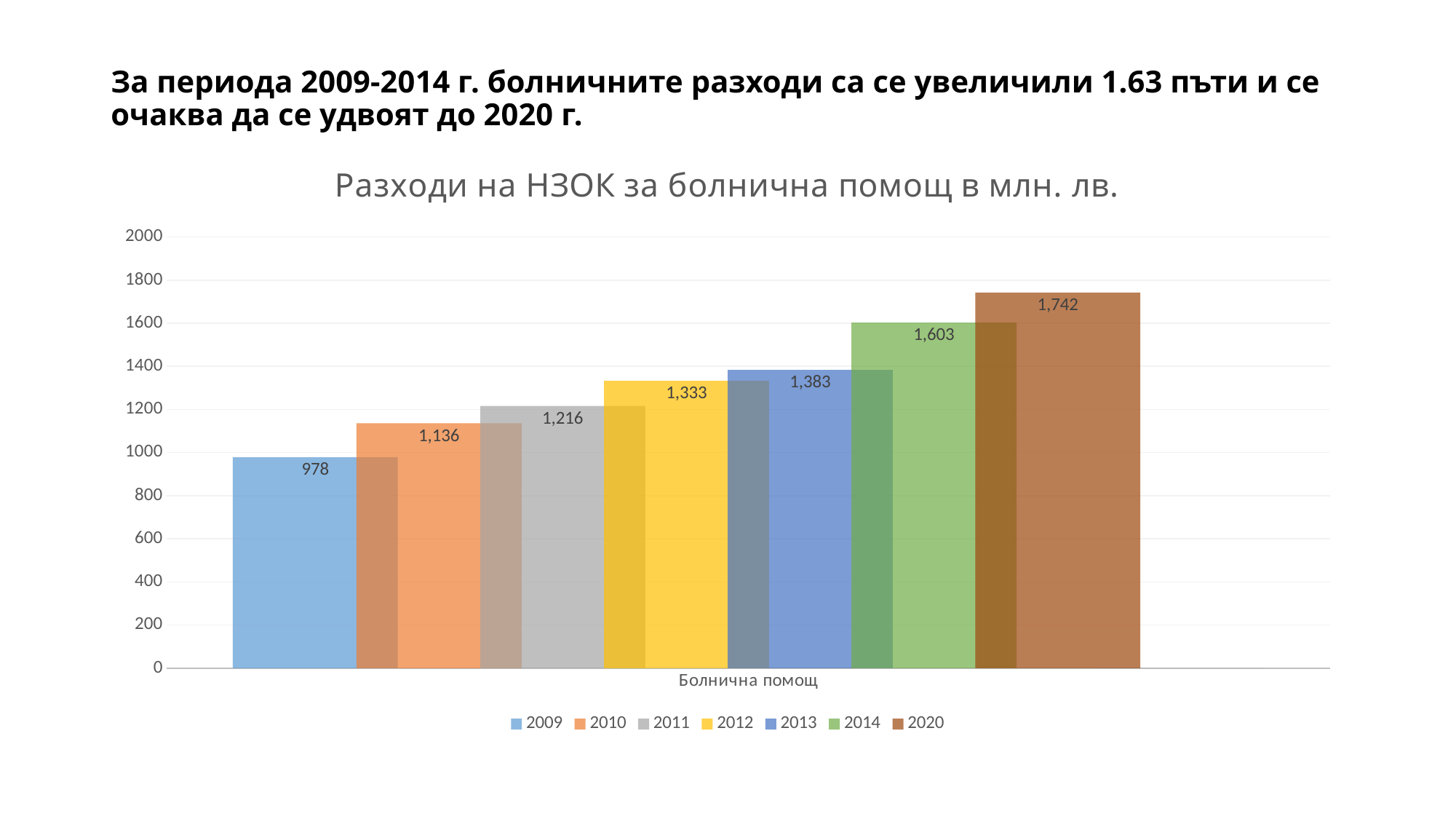
What is the value for 2014 in the chart? 1,603 What is the value for 2012 in the chart? 1,333 What is the difference between the values for 2020 and 2014? 139 What kind of chart is shown on the slide? bar chart What is the difference between the values for 2014 and 2009? 625 What is the value for 2009 in the chart? 978 What is the value for 2020 in the chart? 1,742 How many series does the legend list? 7 Which series has the lowest value? 2009 Which is larger, the value for 2011 or the value for 2013? 2013 What is the title of the chart? Разходи на НЗОК за болнична помощ в млн. лв. Which series has the highest value? 2020